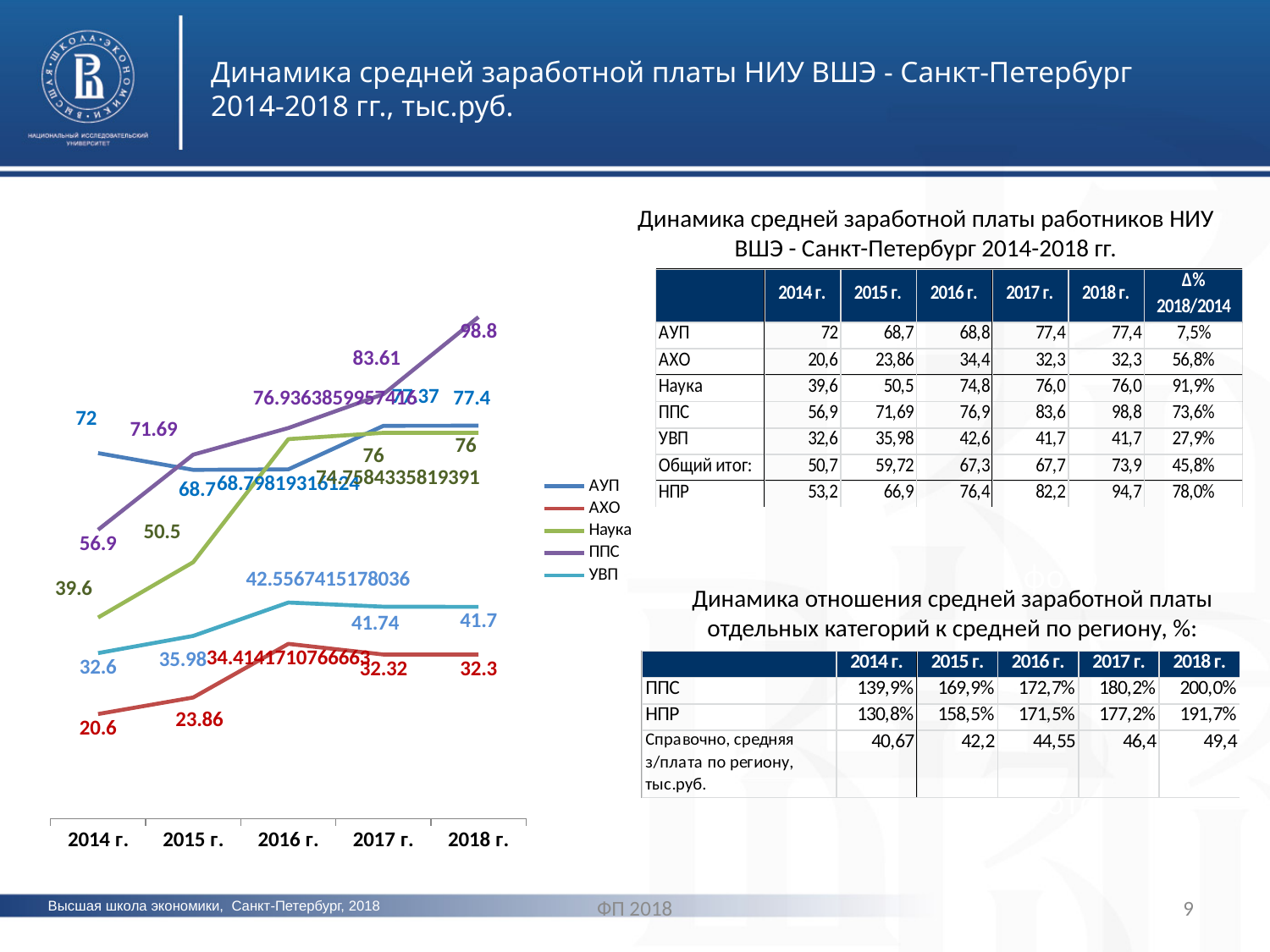
In the line chart, by how much did the ППС value increase from 2014 г. to 2018 г.? 41.9 In the line chart, which series has the highest value in 2018 г.? ППС In the line chart, does the ППС series rise or fall from 2014 г. to 2018 г.? rise How many years are shown along the x axis of the line chart? 5 In the line chart, what is the value for ППС in 2018 г.? 98.8 In the line chart, what is the value for АХО in 2014 г.? 20.6 In the line chart, what is the value for АУП in 2014 г.? 72 In the line chart, what is the value for УВП in 2018 г.? 41.7 In the line chart, which series has the lowest value in 2014 г.? АХО What kind of chart is shown on the left of the slide? line chart In the line chart, what is the value for Наука in 2015 г.? 50.5 How many series does the legend of the line chart list? 5